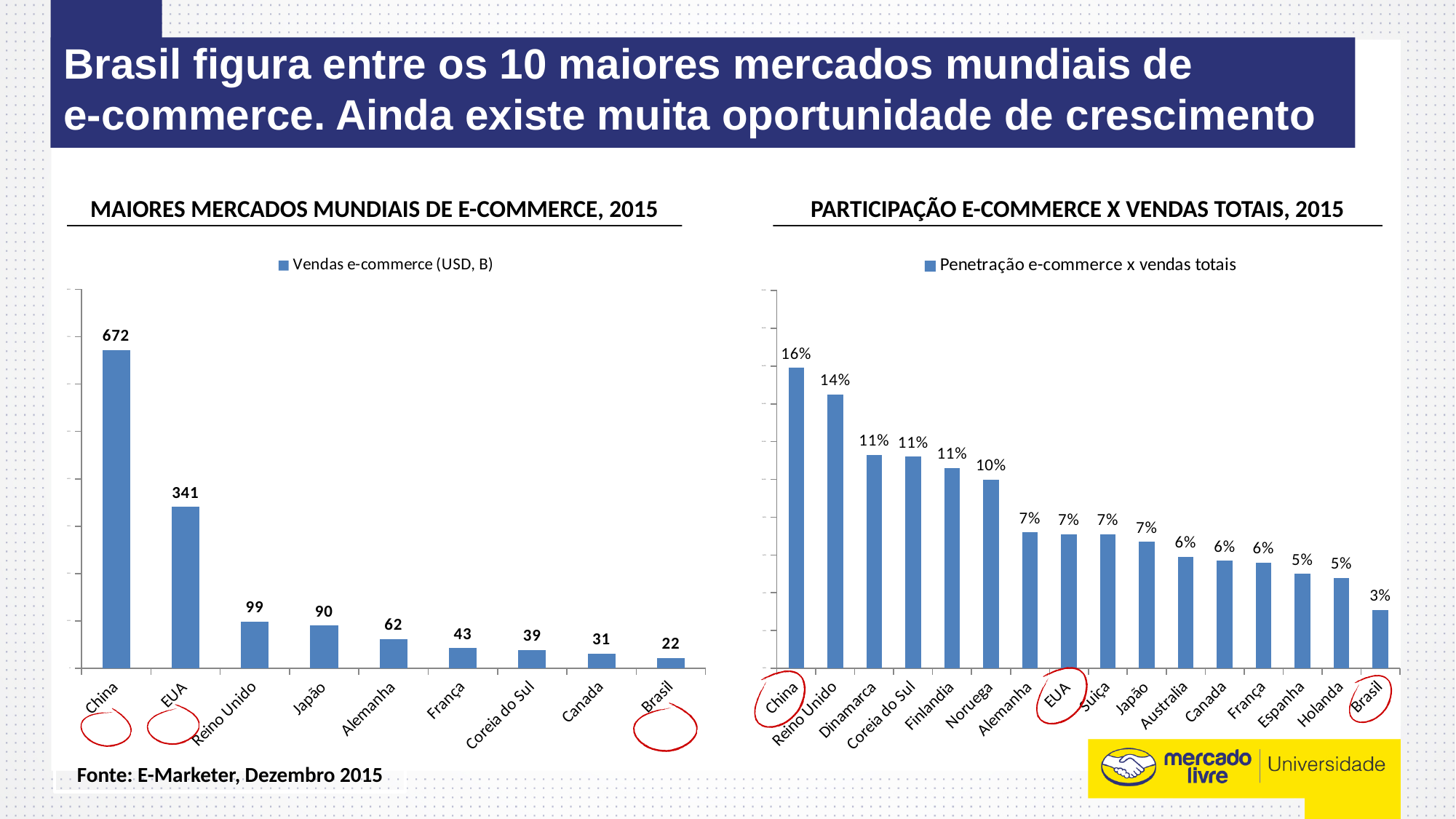
In the chart titled 'MAIORES MERCADOS MUNDIAIS DE E-COMMERCE, 2015', what is the value for Brasil? 22 In the chart titled 'MAIORES MERCADOS MUNDIAIS DE E-COMMERCE, 2015', which country has the lowest value? Brasil In the chart titled 'MAIORES MERCADOS MUNDIAIS DE E-COMMERCE, 2015', which is larger, the value for Reino Unido or Japão? Reino Unido In the chart titled 'PARTICIPAÇÃO E-COMMERCE X VENDAS TOTAIS, 2015', what is the difference between the values for China and Brasil? 13% In the chart titled 'MAIORES MERCADOS MUNDIAIS DE E-COMMERCE, 2015', what is the difference between the values for China and EUA? 331 What kind of chart is the chart titled 'MAIORES MERCADOS MUNDIAIS DE E-COMMERCE, 2015'? Bar chart In the chart titled 'PARTICIPAÇÃO E-COMMERCE X VENDAS TOTAIS, 2015', what is the value for Brasil? 3% In the chart titled 'MAIORES MERCADOS MUNDIAIS DE E-COMMERCE, 2015', how many countries are shown? 9 In the chart titled 'PARTICIPAÇÃO E-COMMERCE X VENDAS TOTAIS, 2015', what is the value for Reino Unido? 14% In the chart titled 'PARTICIPAÇÃO E-COMMERCE X VENDAS TOTAIS, 2015', which country has the highest value? China In the chart titled 'PARTICIPAÇÃO E-COMMERCE X VENDAS TOTAIS, 2015', how many countries are shown? 16 In the chart titled 'MAIORES MERCADOS MUNDIAIS DE E-COMMERCE, 2015', what is the value for China? 672